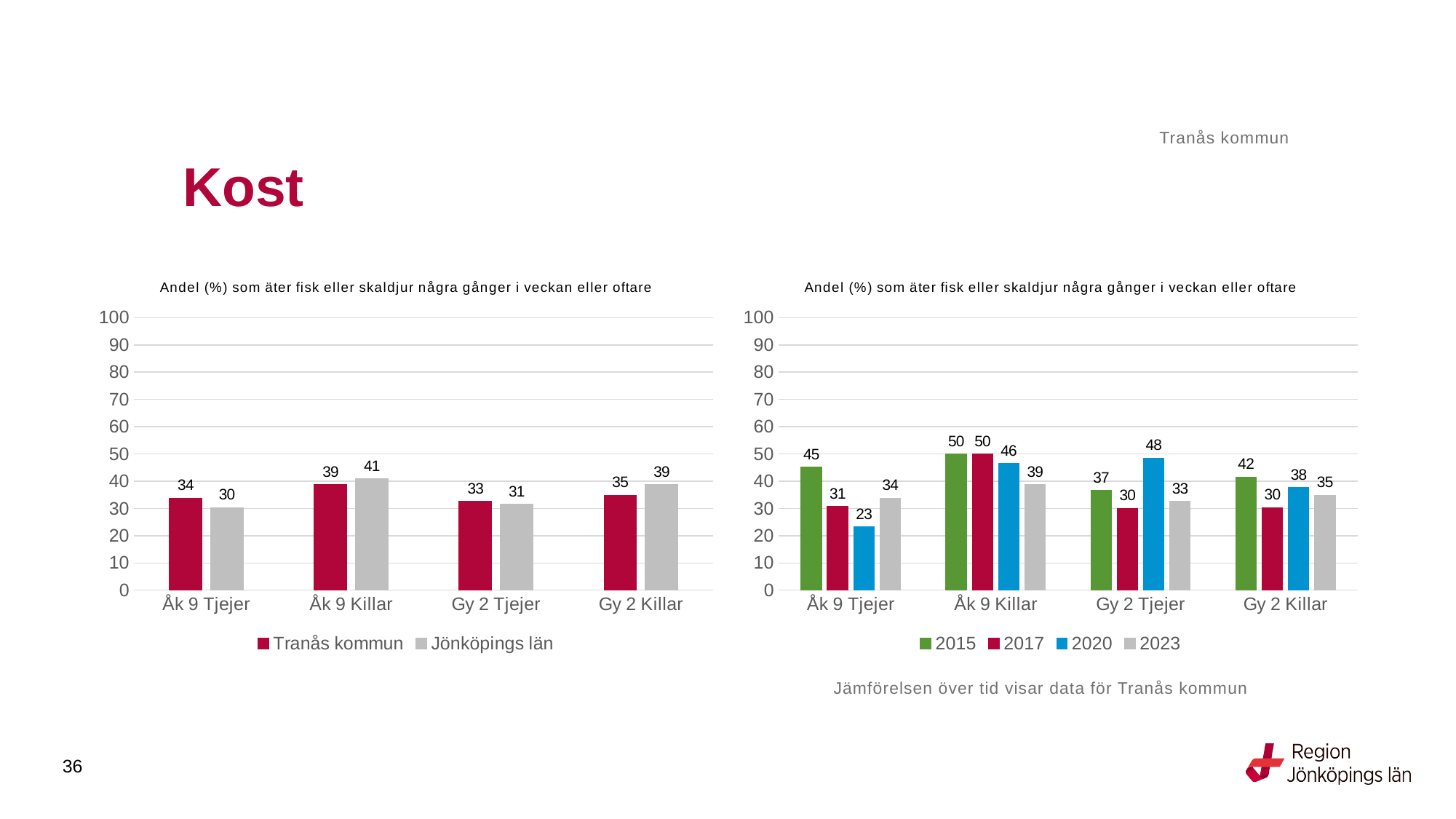
In the left chart, which is larger for Åk 9 Tjejer: Tranås kommun or Jönköpings län? Tranås kommun How many categories are shown on the x axis of the right chart? 4 What kind of chart is the right chart? Bar chart How many series does the legend of the left chart list? 2 How many series does the legend of the right chart list? 4 In the left chart, what is the value for Jönköpings län for Gy 2 Tjejer? 31 In the right chart, which category has the lowest value for 2015? Gy 2 Tjejer In the left chart, which category has the highest value for Jönköpings län? Åk 9 Killar In the right chart, what is the value for 2020 for Åk 9 Tjejer? 23 In the left chart, what is the difference between Tranås kommun and Jönköpings län for Gy 2 Killar? 4 In the right chart, what is the difference between the 2020 and 2017 values for Gy 2 Tjejer? 18 In the left chart, what is the value for Tranås kommun for Åk 9 Killar? 39